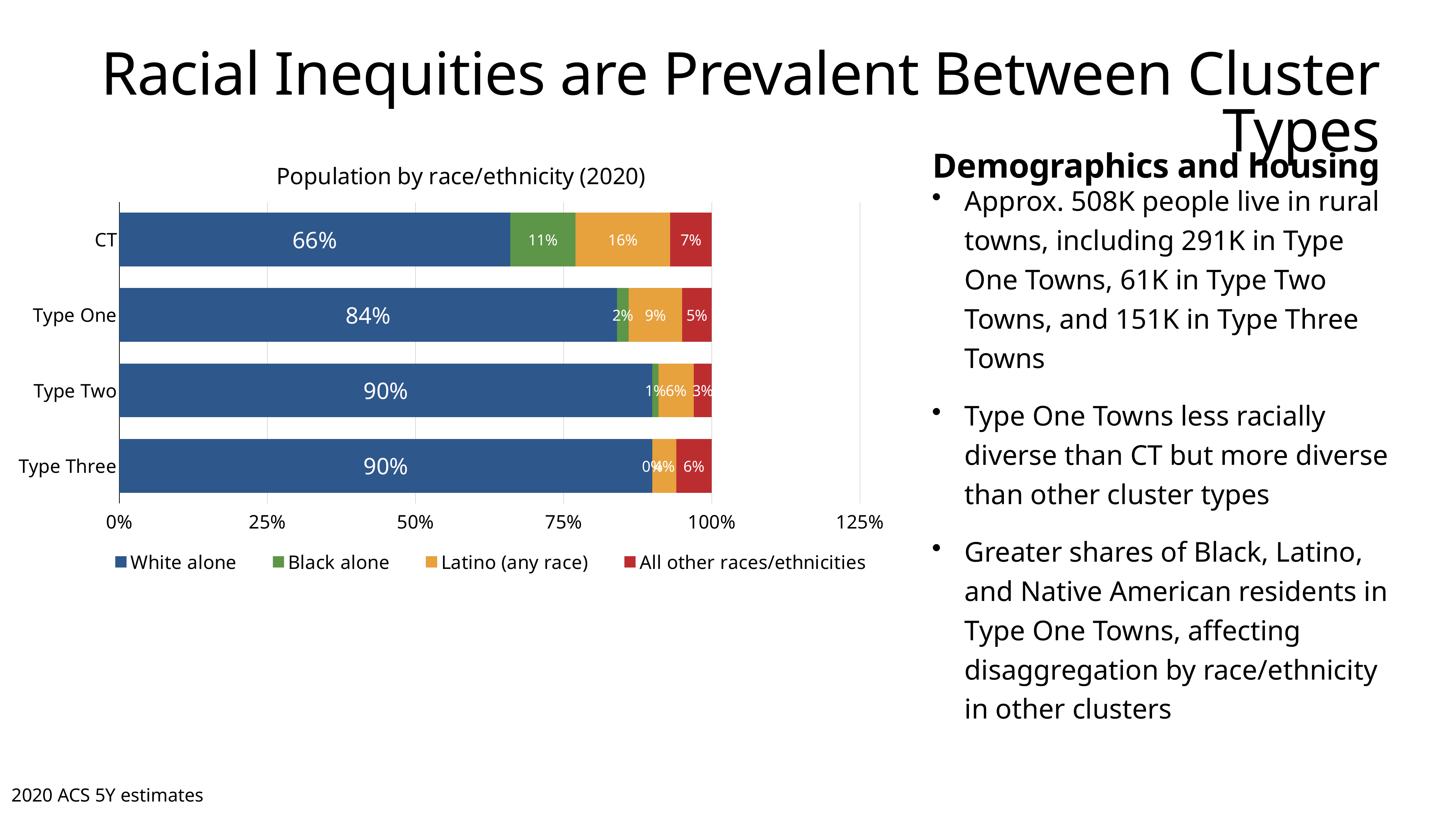
Which category has the highest Black alone share? CT What is the All other races/ethnicities share for Type Three towns? 6% How many series does the chart legend list? 4 What is the Black alone share for Type One towns? 2% Which category has the lowest White alone share? CT What is the Latino (any race) share for CT? 16% Is the Latino (any race) share larger for CT or for Type One? CT What is the White alone share for CT? 66% What is the title of the chart? Population by race/ethnicity (2020) What type of chart is shown on the slide? Stacked bar chart How many categories (bars) are shown on the chart? 4 What is the difference between the White alone share for Type One and for CT? 18%